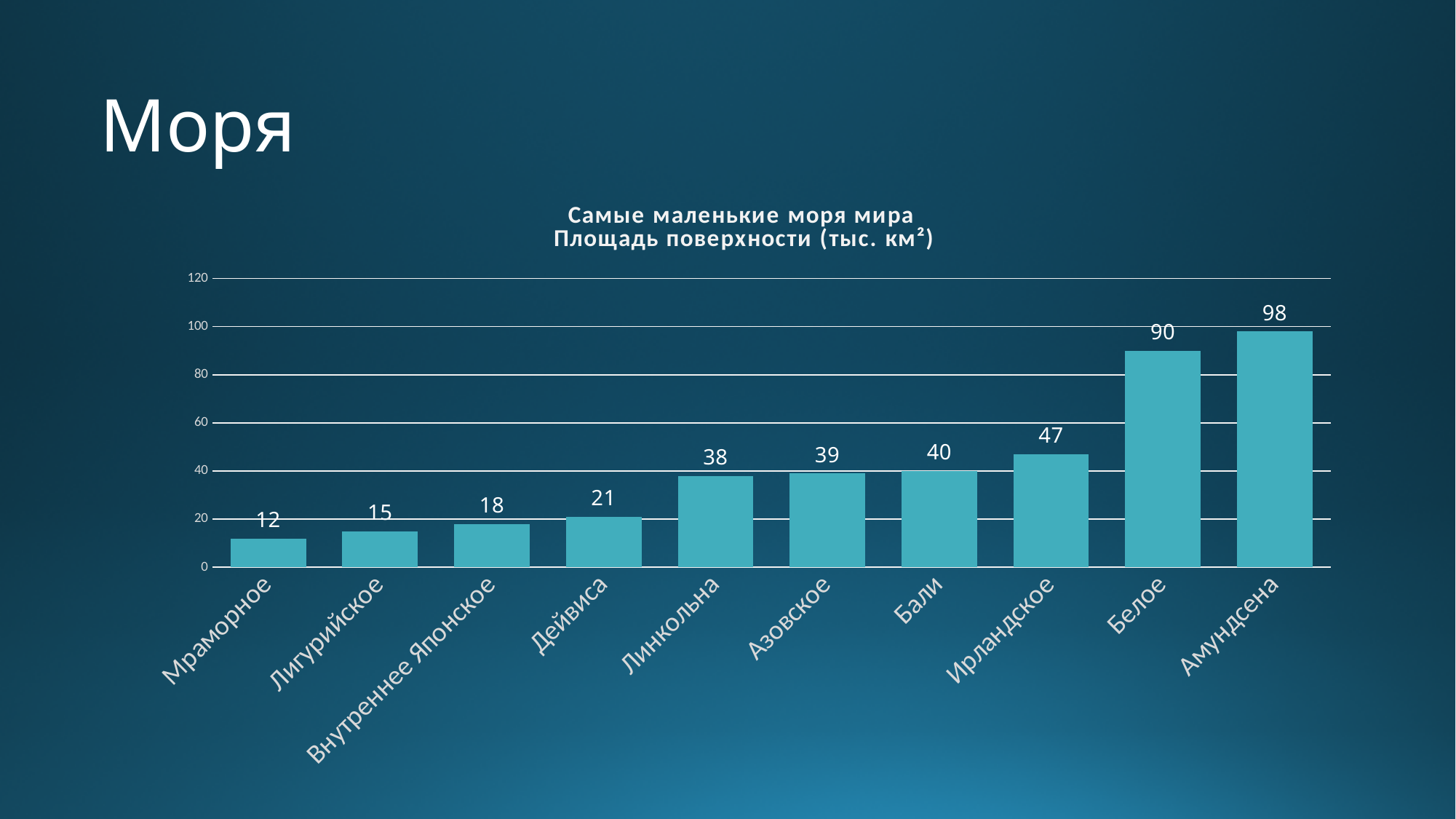
What is the value shown for Белое? 90 Do the values rise or fall from left to right along the x axis? rise Which sea has the highest value on the chart? Амундсена How many seas are shown on the chart? 10 Which sea has the lowest value on the chart? Мраморное What kind of chart is shown on the slide? bar chart Which has a larger value, Линкольна or Ирландское? Ирландское What is the difference between the values for Амундсена and Белое? 8 What is the difference between the values for Ирландское and Мраморное? 35 What is the value shown for Дейвиса? 21 What is the surface area value shown for Азовское? 39 Is the value for Белое greater or less than 80? greater